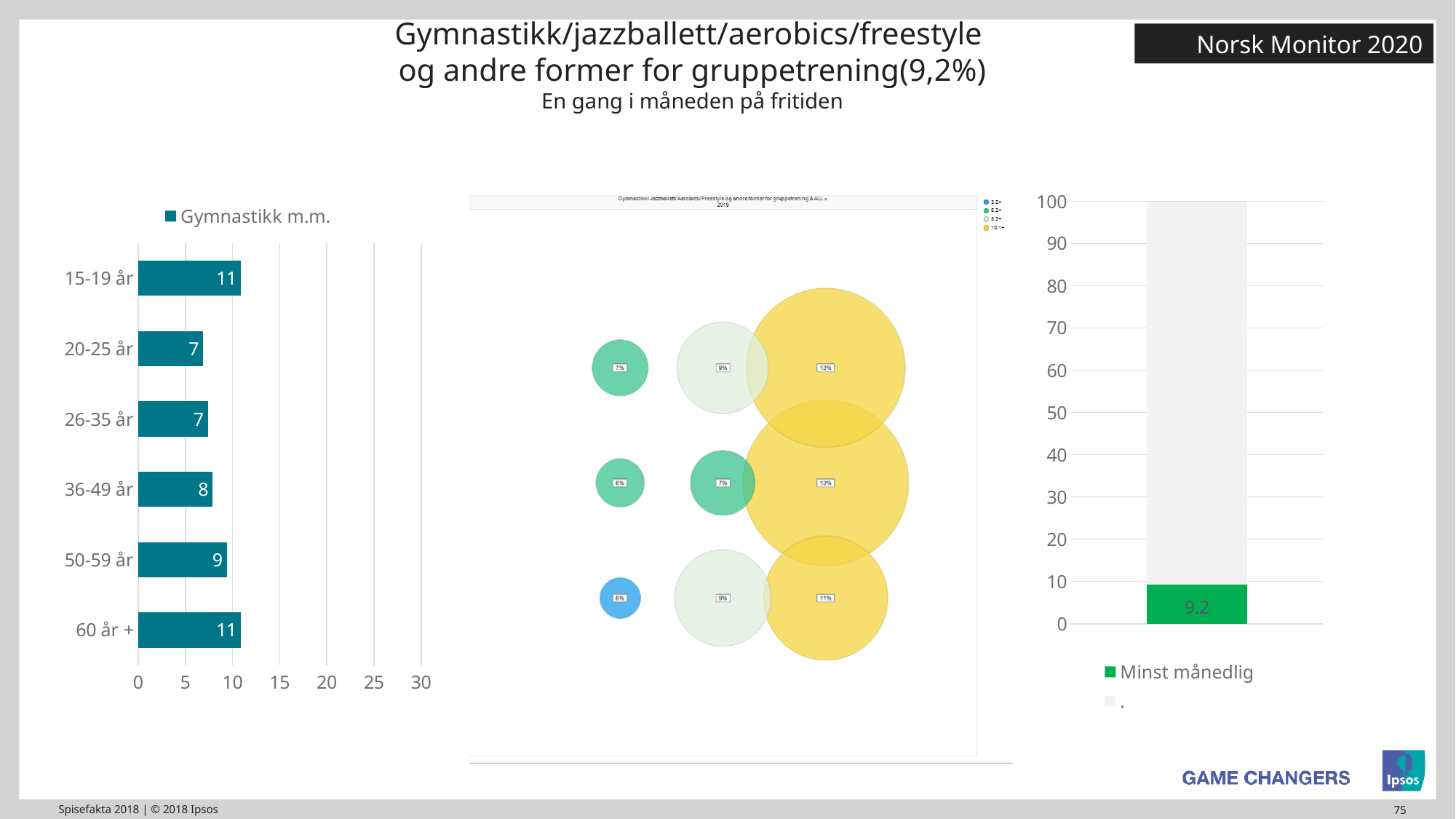
In the left bar chart, how many age groups are shown? 6 In the left bar chart, what is the difference between the values for 60 år + and 20-25 år? 4 In the left bar chart, what is the series name shown in the legend? Gymnastikk m.m. What kind of chart is the left chart? bar chart In the left bar chart, what is the value for 15-19 år? 11 In the left bar chart, what is the value for 36-49 år? 8 In the left bar chart, which age group has the lowest value? 20-25 år and 26-35 år (both 7) In the left bar chart, which is larger, the value for 50-59 år or the value for 36-49 år? 50-59 år In the right bar chart, what is the highest value shown on the vertical axis? 100 In the left bar chart, what is the value for 50-59 år? 9 In the right bar chart, is the value for Minst månedlig greater or less than 10? less In the right bar chart, what is the value for Minst månedlig? 9.2